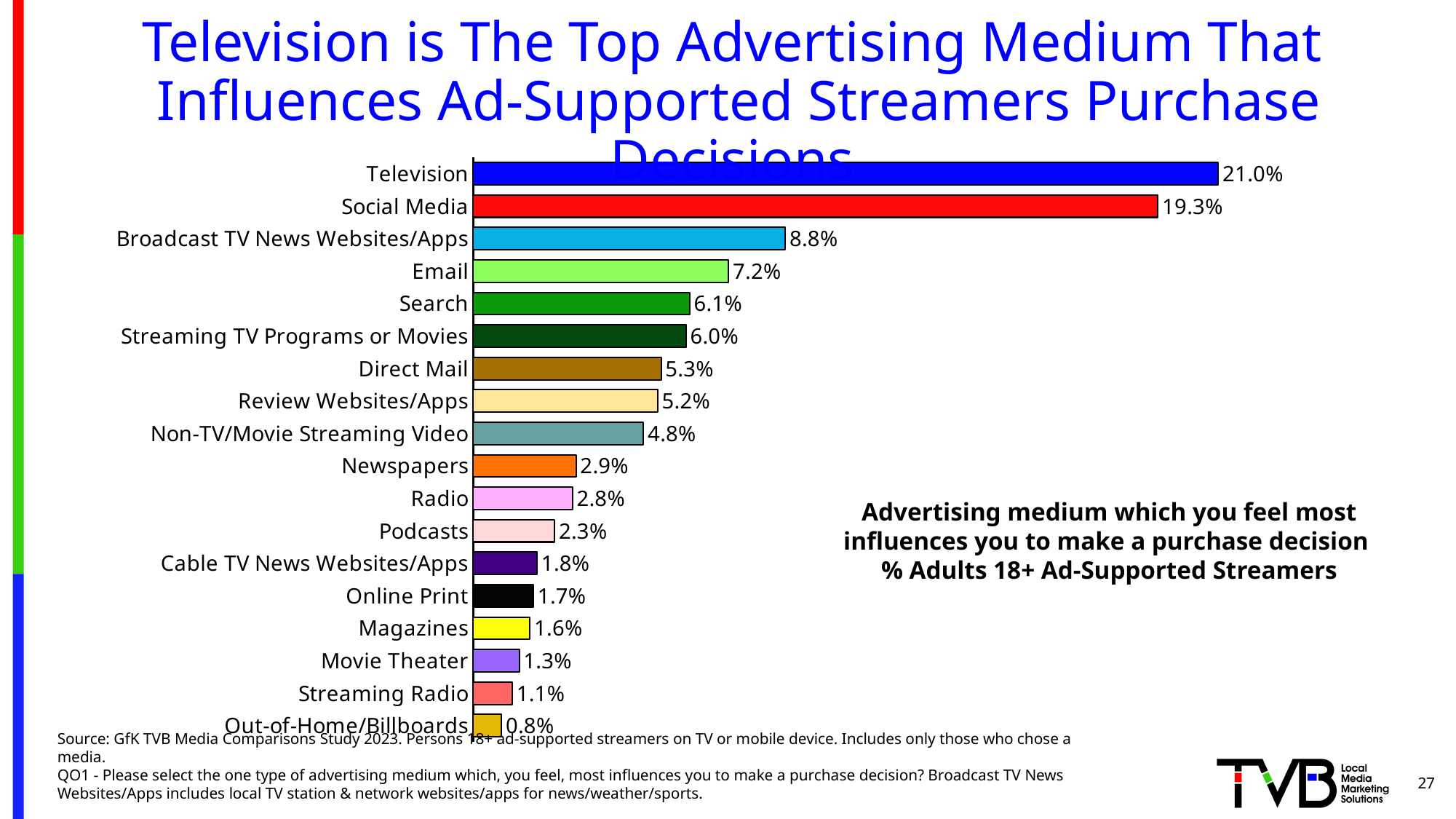
What is the difference between the values for Television and Social Media? 1.7% What kind of chart is shown on the slide? Bar chart How many advertising media are listed on the chart? 18 Which advertising medium has the lowest value on the chart? Out-of-Home/Billboards Which advertising medium has the highest value on the chart? Television What is the difference between the values for Email and Search? 1.1% What is the value shown for Radio? 2.8% What percentage of ad-supported streamers chose Television as the advertising medium that most influences their purchase decisions? 21.0% What is the value shown for Broadcast TV News Websites/Apps? 8.8% What is the value shown for Social Media? 19.3% What colour is the bar for Social Media? Red Which has a larger value, Direct Mail or Newspapers? Direct Mail